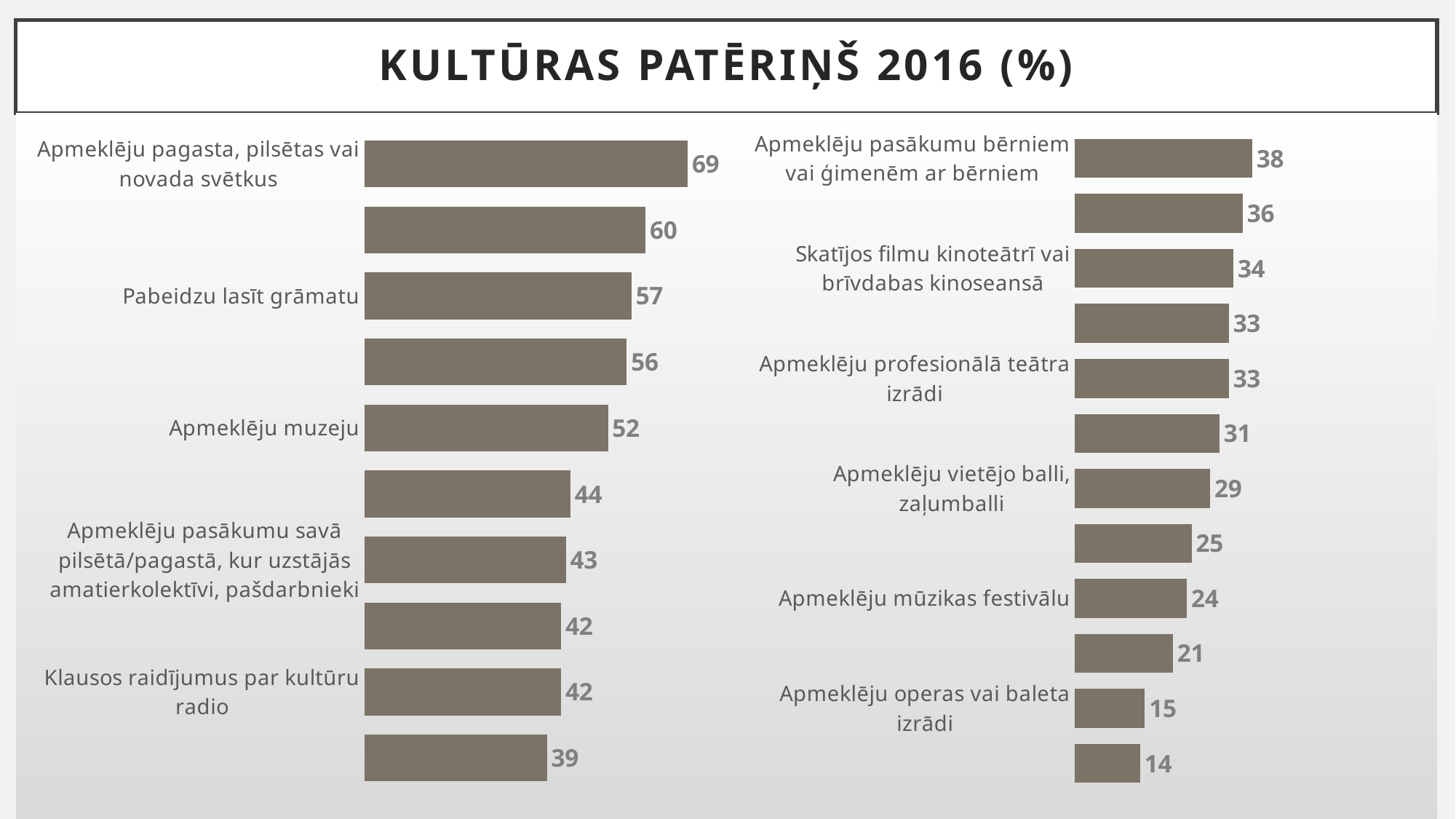
What is the title of the slide? KULTŪRAS PATĒRIŅŠ 2016 (%) On the right chart, what is the value for 'Apmeklēju operas vai baleta izrādi'? 15 On the right chart, what is the value for 'Apmeklēju mūzikas festivālu'? 24 On the left chart, what is the value for 'Apmeklēju muzeju'? 52 On the right chart, which labelled category has the highest value? Apmeklēju pasākumu bērniem vai ģimenēm ar bērniem On the left chart, what is the value for 'Apmeklēju pagasta, pilsētas vai novada svētkus'? 69 What kind of chart is the left chart? Bar chart On the left chart, what is the difference between 'Pabeidzu lasīt grāmatu' and 'Apmeklēju muzeju'? 5 On the right chart, which is larger: 'Skatījos filmu kinoteātrī vai brīvdabas kinoseansā' or 'Apmeklēju vietējo balli, zaļumballi'? Skatījos filmu kinoteātrī vai brīvdabas kinoseansā On the left chart, what is the value for 'Pabeidzu lasīt grāmatu'? 57 How many bars are shown on the right chart? 12 On the left chart, which labelled category has the highest value? Apmeklēju pagasta, pilsētas vai novada svētkus